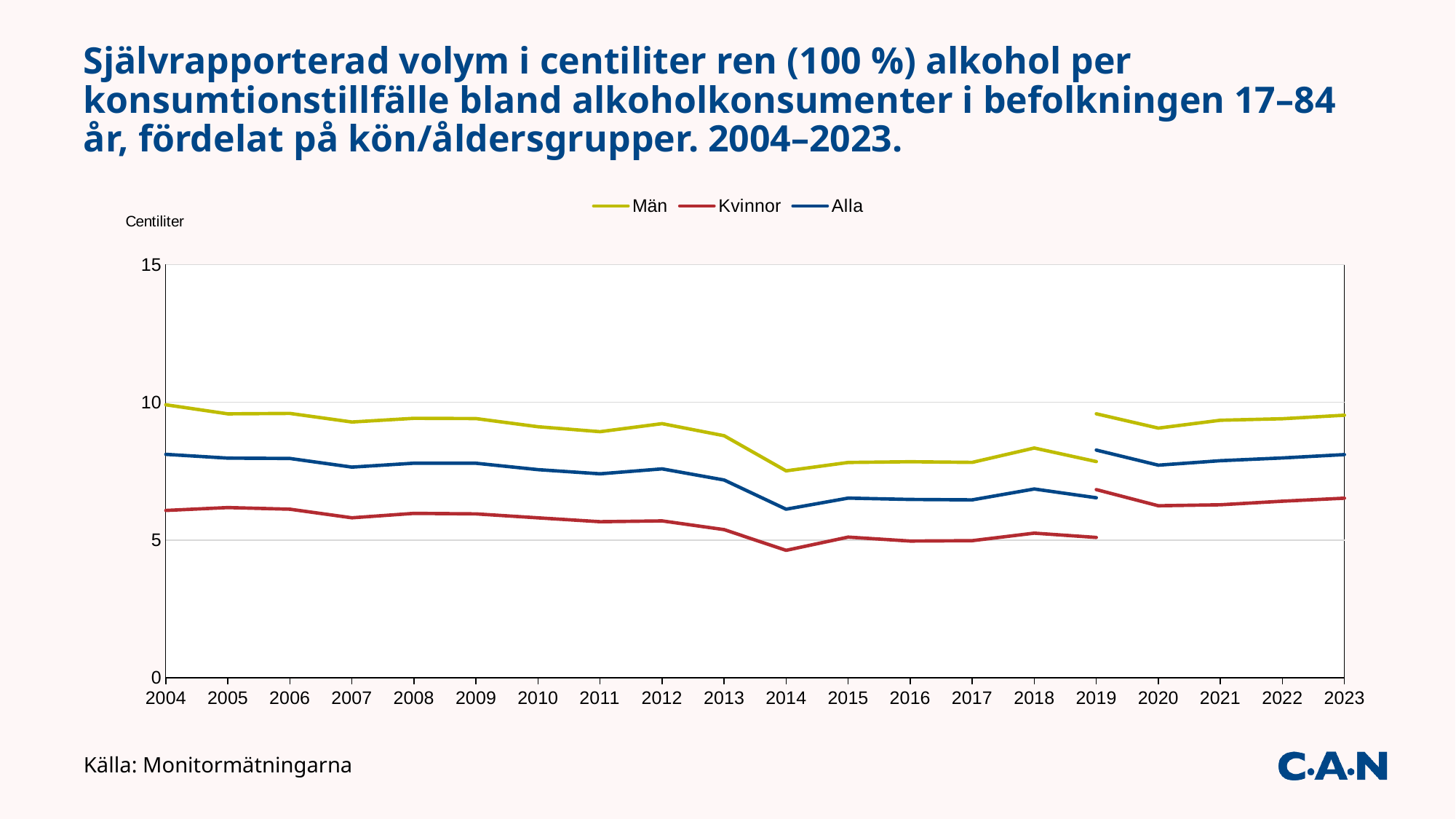
Which series has the lowest values throughout the chart? Kvinnor Which series has the highest values throughout the chart? Män What unit label is shown above the y axis? Centiliter How many series does the legend list? 3 In which year does the Kvinnor series reach its lowest value? 2014 Is the value for Kvinnor in 2014 greater or less than 5? less Which is larger in 2010, the value for Män or the value for Kvinnor? Män What kind of chart is shown on the slide? line chart Is the value for Alla in 2014 greater or less than 5? greater How many years are shown on the x axis? 20 Does the Män series rise or fall from 2004 to 2014? fall